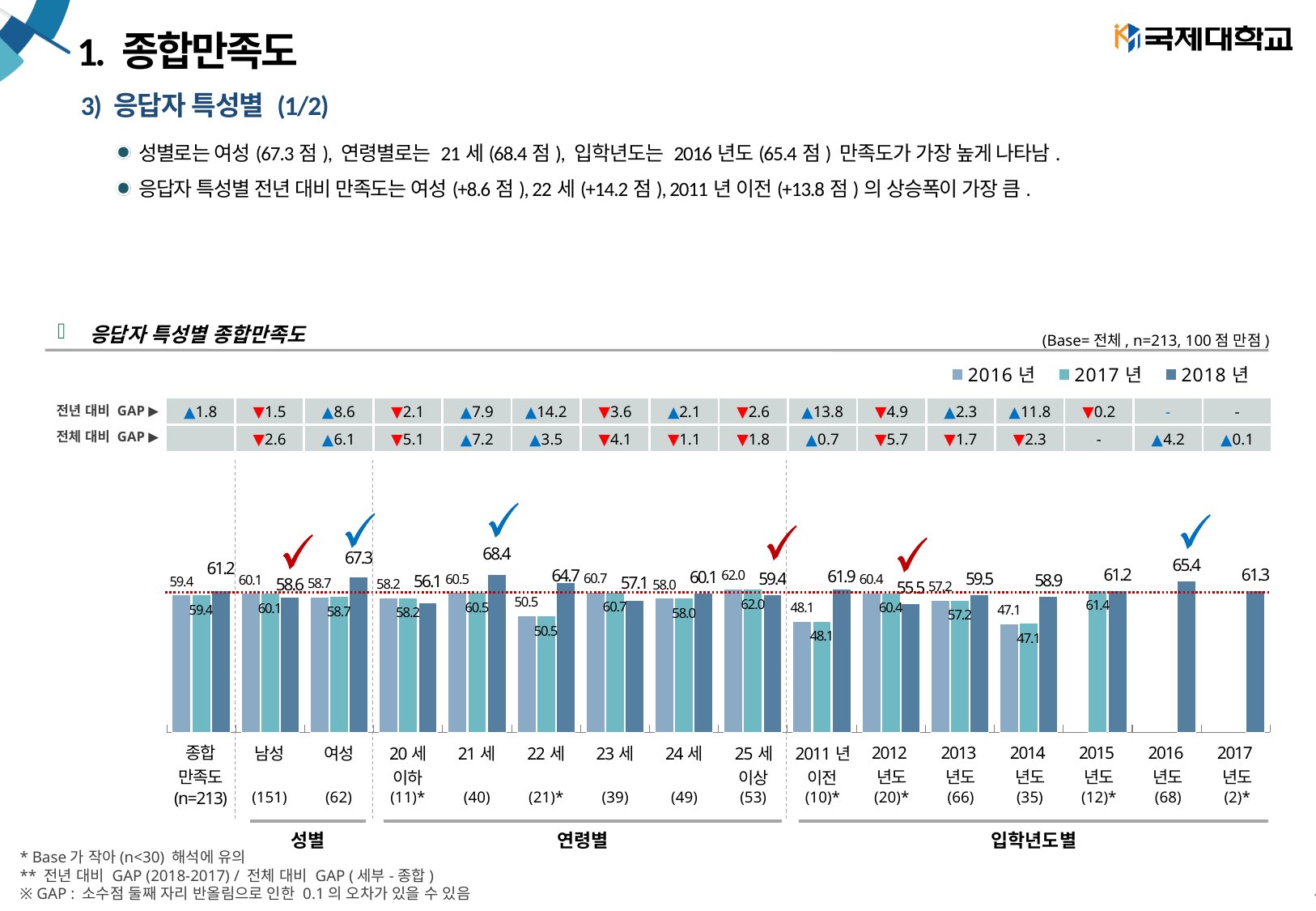
What is the difference between the 2018년 and 2017년 values for 22세? 14.2 What is the 2018년 value for 종합만족도 (n=213)? 61.2 What is the 2018년 value for 2011년 이전? 61.9 Which category has the lowest 2017년 value in the chart? 2014년도 Which has the larger 2018년 value, 2016년도 or 2017년도? 2016년도 What kind of chart is shown on the slide? Bar chart How many series does the legend list? 3 Among the 입학년도별 categories, which has the lowest 2018년 value? 2012년도 Among the 연령별 categories, which has the highest 2018년 value? 21세 What is the difference between the 2018년 values for 여성 and 남성? 8.7 What is the 2018년 value for 여성 in the 응답자 특성별 종합만족도 chart? 67.3 What is the 2018년 value for 21세 in the chart? 68.4